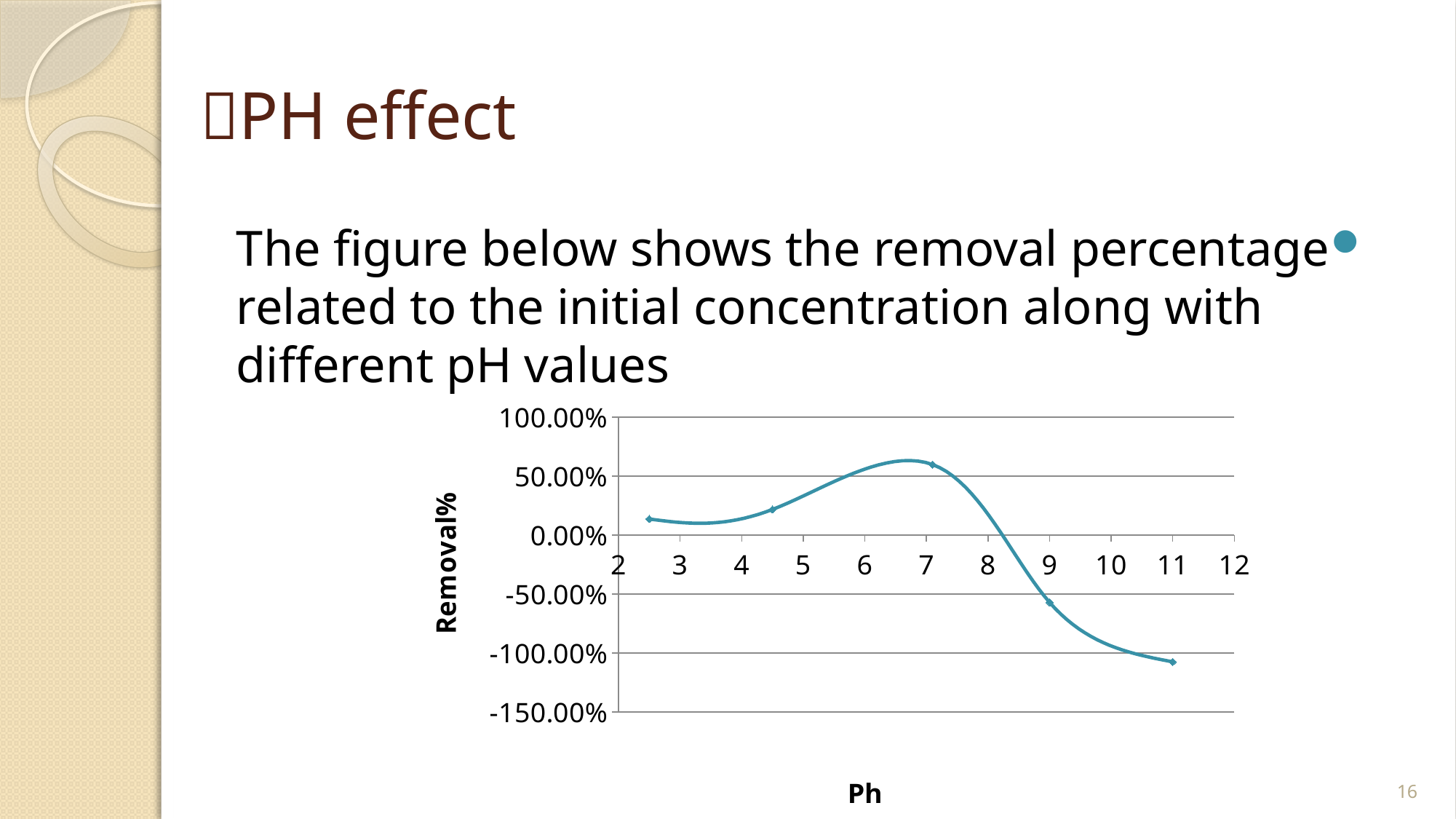
Is the removal percentage at pH 4.5 greater or less than 50.00%? less How many data points are plotted on the chart? 5 Is the removal percentage at pH 11 greater or less than -50.00%? less What is the title of the x axis of the chart? Ph At which pH value is the removal percentage lowest? 11 Does the removal percentage rise or fall as pH increases from 7 to 11? fall Is the removal percentage at pH 9 greater or less than 0.00%? less Which has the higher removal percentage, pH 7 or pH 9? pH 7 What kind of chart is shown on the slide? line chart What is the title of the y axis of the chart? Removal%